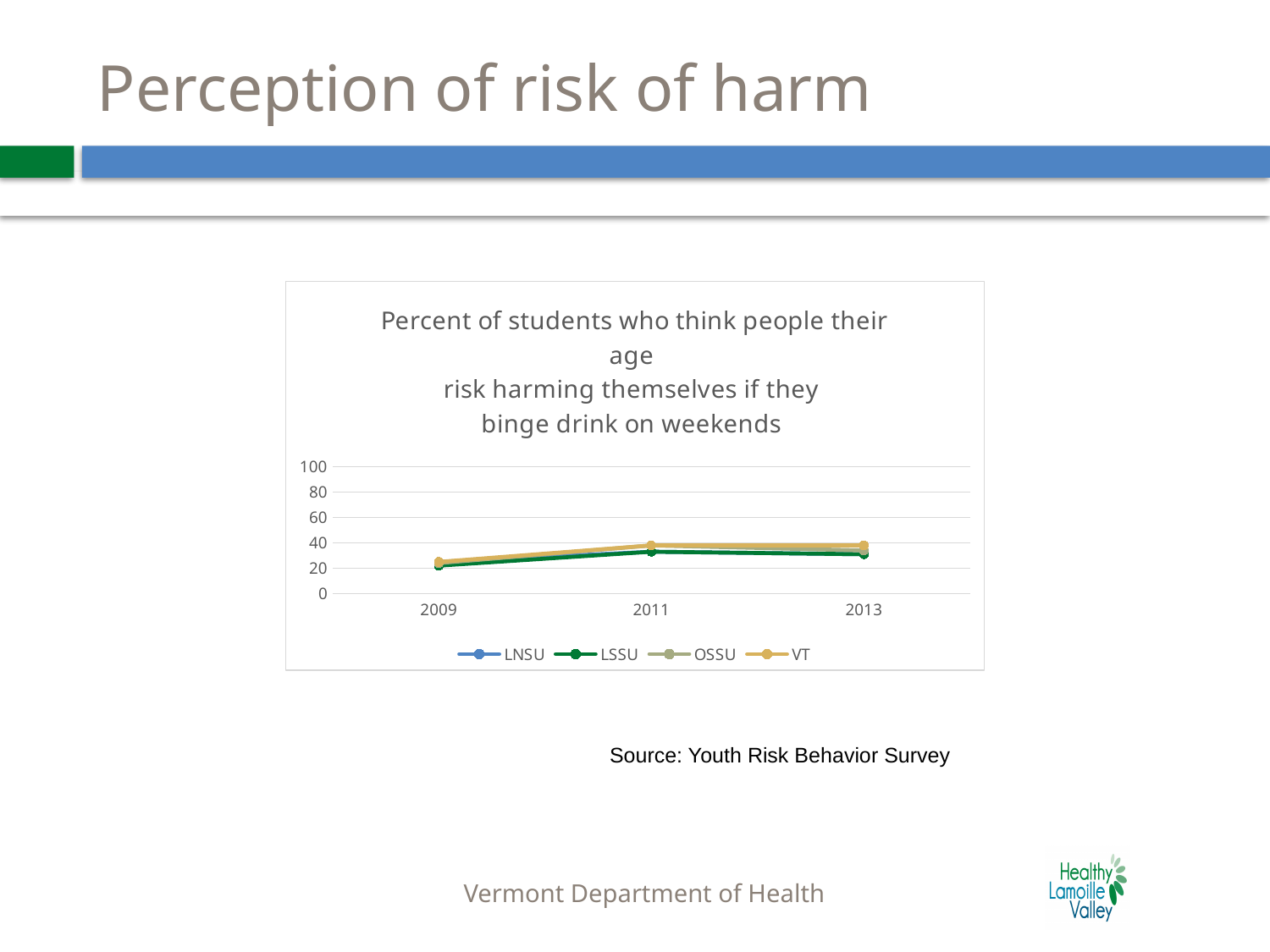
What is the highest value shown on the y axis? 100 How many series does the legend list? 4 Do the values for VT rise or fall from 2009 to 2011? rise Is the value for OSSU in 2013 greater or less than 20? greater Is the value for LNSU in 2011 greater or less than 80? less Do the values for LSSU rise or fall from 2009 to 2013? rise Is the value for VT in 2013 greater or less than 60? less Which series are listed in the legend? LNSU, LSSU, OSSU, VT How many years are shown on the x axis? 3 What kind of chart is shown on the slide? line chart What is the title of the chart? Percent of students who think people their age risk harming themselves if they binge drink on weekends